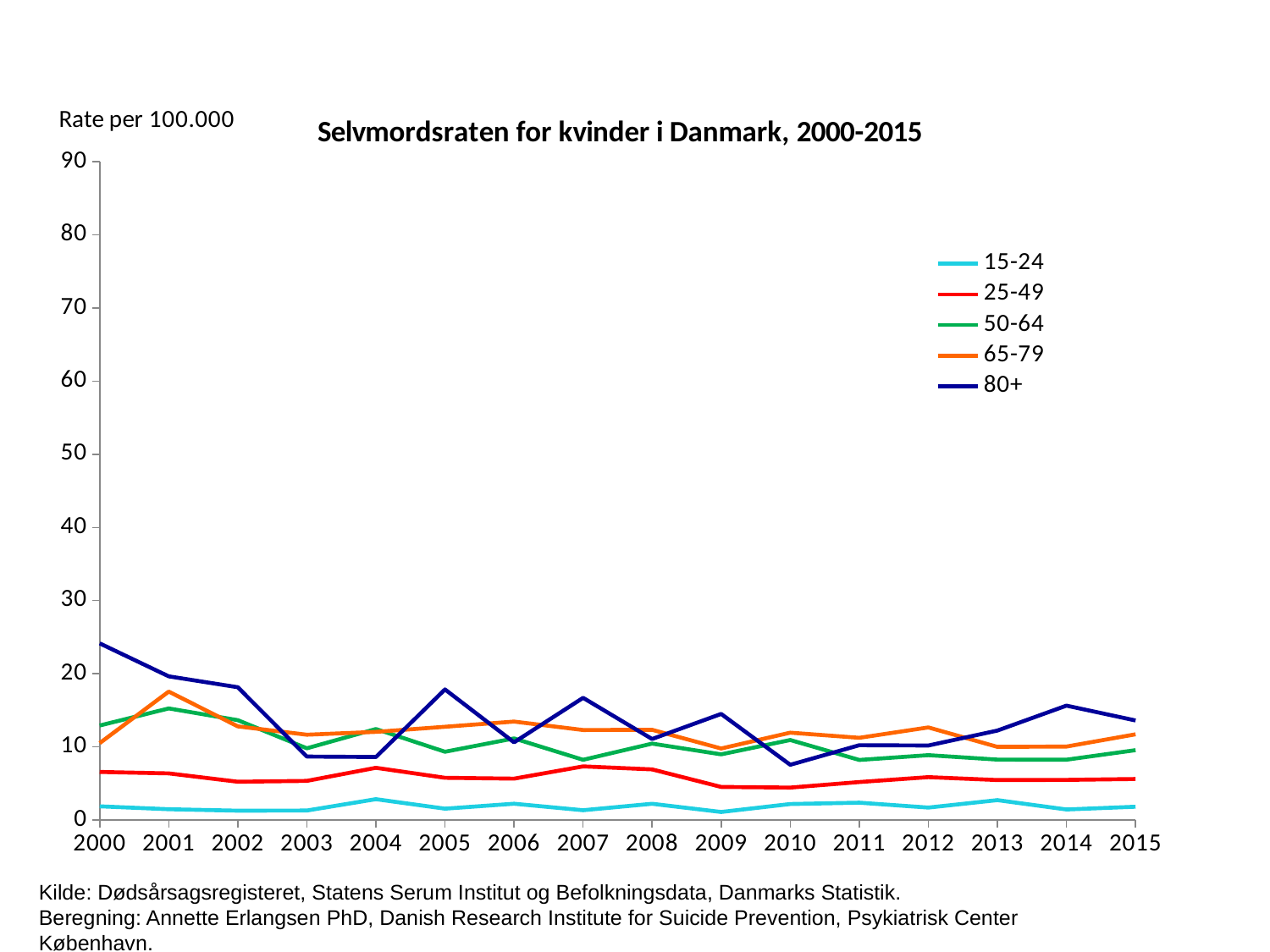
Is the value for the 15-24 series in 2004 greater or less than 10? less Is the value for the 80+ series in 2000 greater or less than 20? greater How many years are shown along the x axis? 16 Which age group has the highest rate in 2000? 80+ Which age group has the lowest rate in 2015? 15-24 What is the title of the chart? Selvmordsraten for kvinder i Danmark, 2000-2015 What kind of chart is shown on the slide? line chart In 2005, which is higher: the 80+ series or the 25-49 series? 80+ How many series does the legend list? 5 In which year does the 80+ series reach its highest value? 2000 What label is shown above the y axis? Rate per 100.000 Is the value for the 80+ series in 2010 greater or less than 10? less